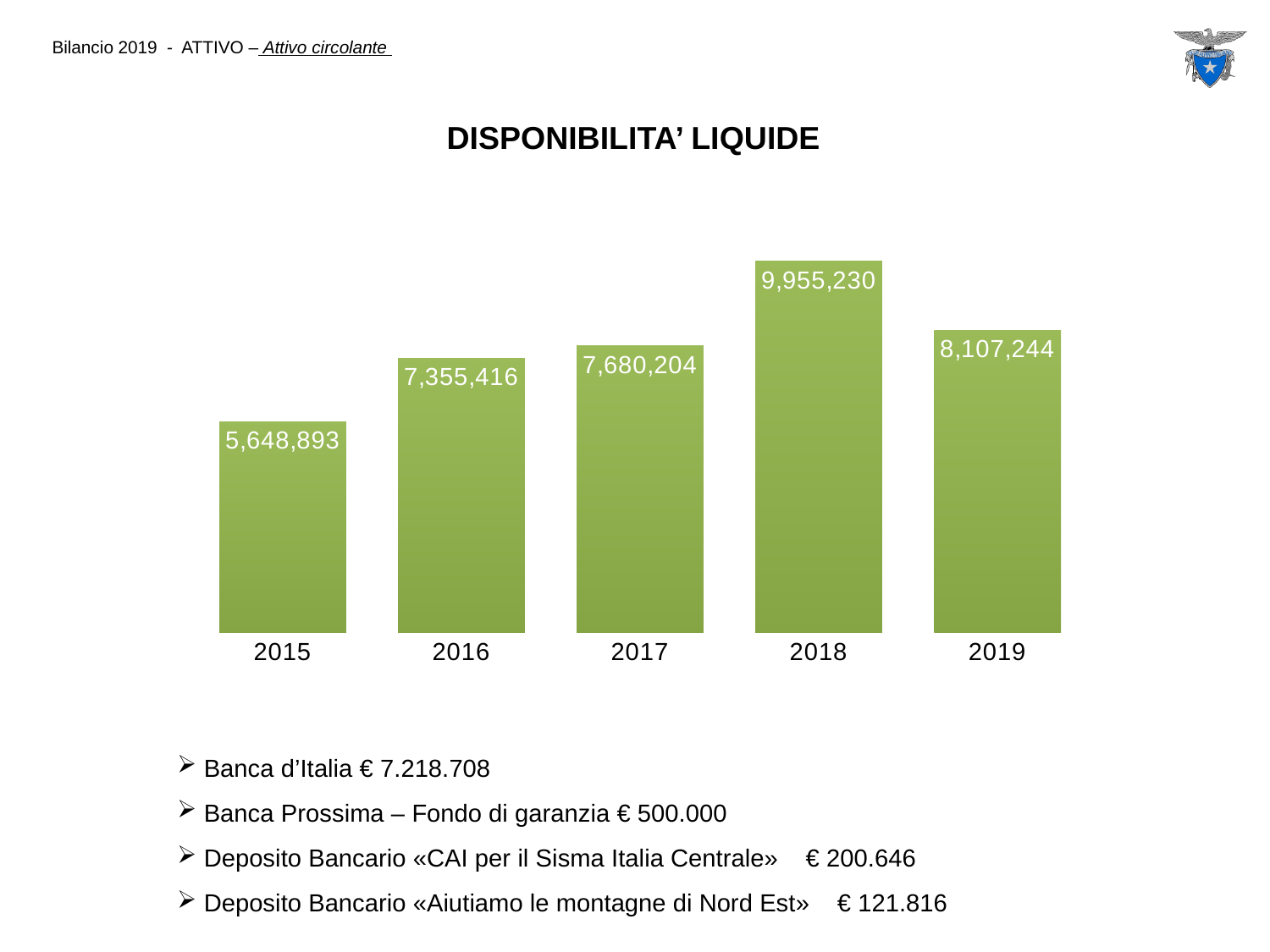
How many years are shown in the chart? 5 What is the value for 2019? 8,107,244 Do the values rise or fall from 2015 to 2018? Rise Which year has the lowest value? 2015 What is the difference between the values for 2018 and 2019? 1,847,986 Which year has the highest value? 2018 What is the title of the chart? DISPONIBILITA' LIQUIDE What is the value for 2015? 5,648,893 What is the difference between the values for 2018 and 2017? 2,275,026 What kind of chart is shown on the slide? Bar chart Which is larger, the value for 2016 or the value for 2019? 2019 What is the value for 2018? 9,955,230